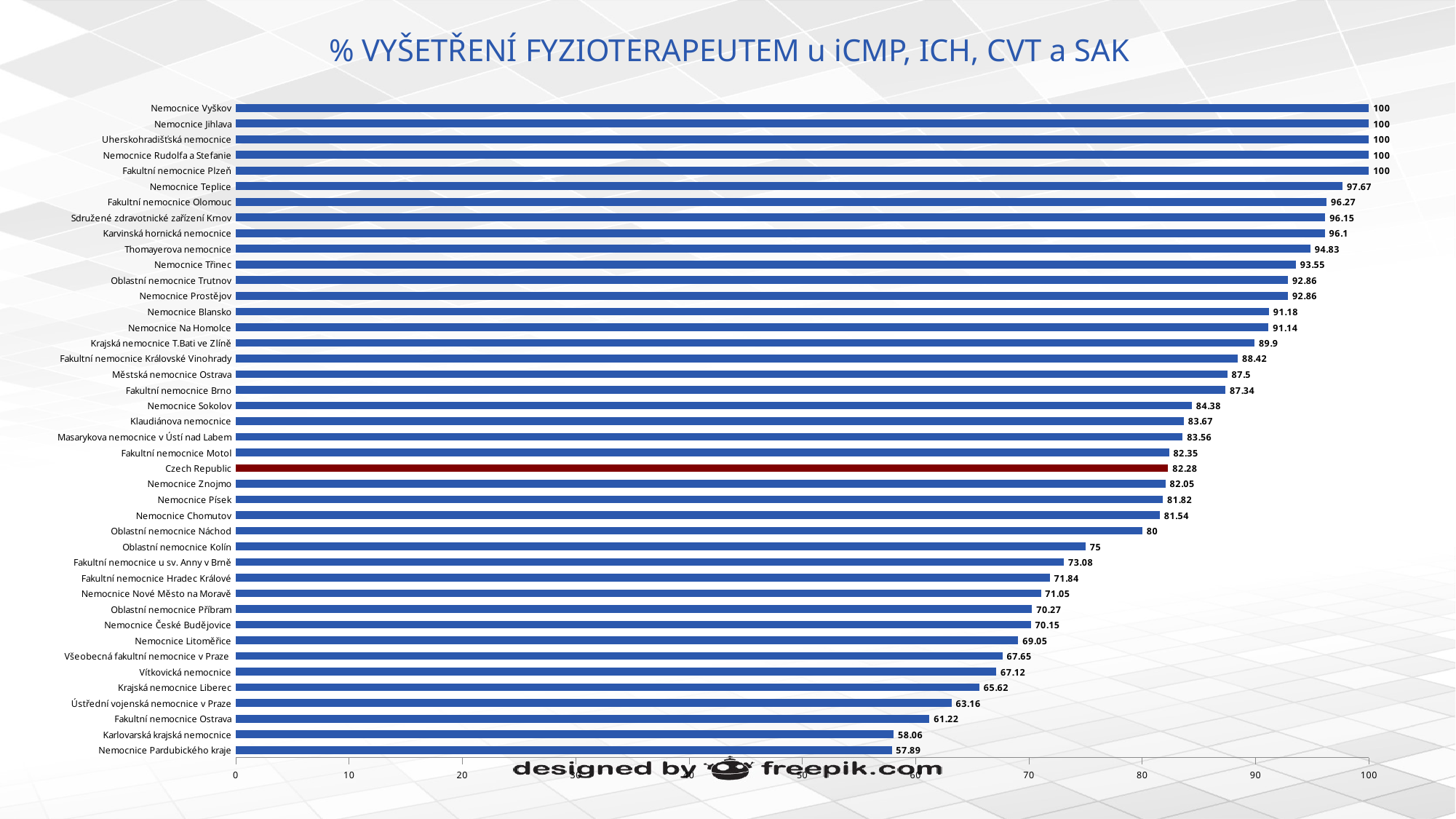
What is the value for Fakultní nemocnice Ostrava? 61.22 What is the difference between the values for Oblastní nemocnice Náchod and Oblastní nemocnice Kolín? 5 What kind of chart is shown on the slide? bar chart How many categories are plotted on the chart? 42 What is the value for Nemocnice Teplice? 97.67 Which category has the lowest value? Nemocnice Pardubického kraje Is the value for Krajská nemocnice Liberec greater or less than 70? less What is the value for Czech Republic? 82.28 What is the value for Fakultní nemocnice Motol? 82.35 Which is larger, the value for Nemocnice Sokolov or the value for Nemocnice Znojmo? Nemocnice Sokolov What is the title of the chart? % VYŠETŘENÍ FYZIOTERAPEUTEM u iCMP, ICH, CVT a SAK Which bar is coloured differently (dark red) from the others? Czech Republic